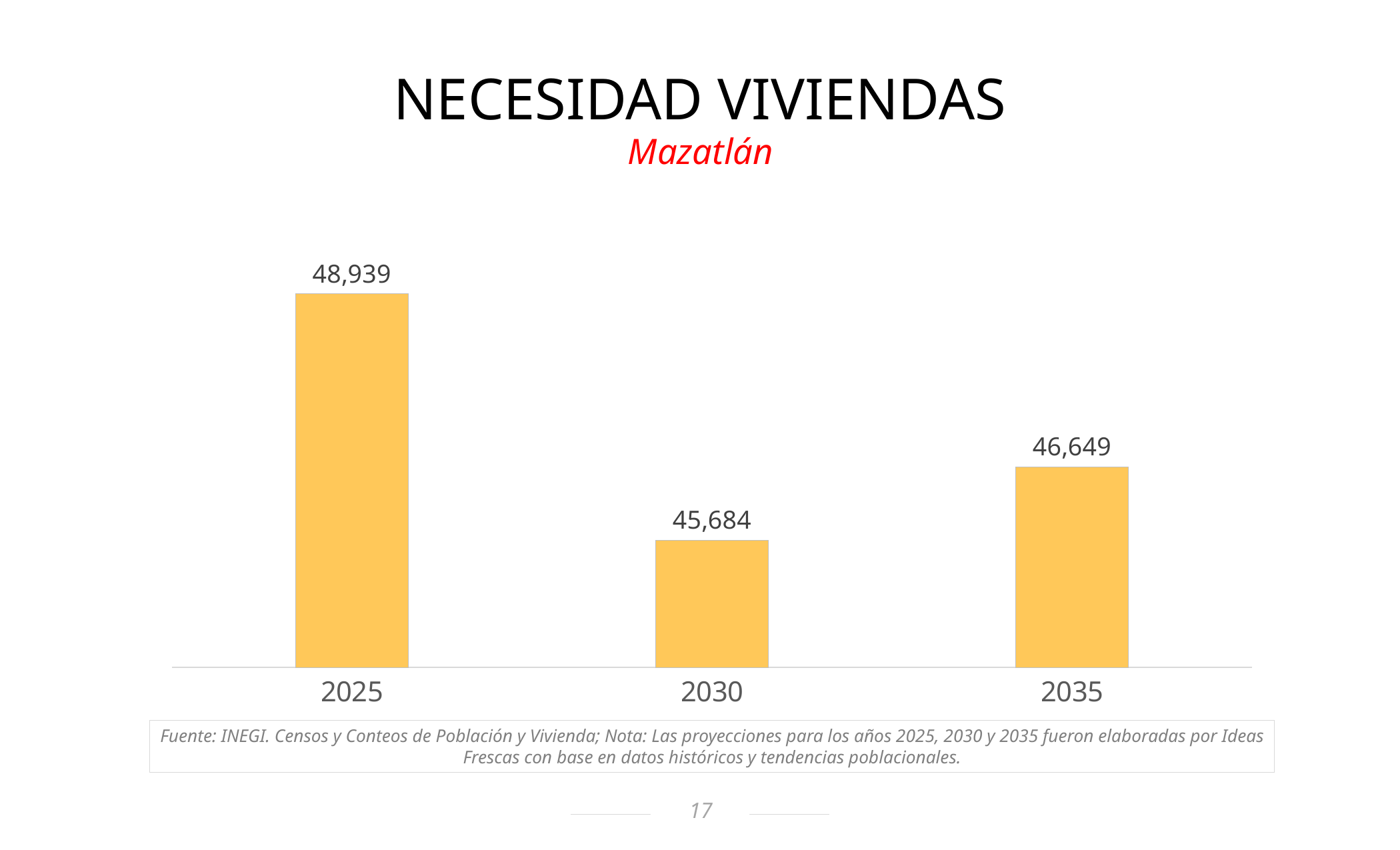
What kind of chart is shown on the slide? Bar chart Which year has the highest value? 2025 What is the title of the chart? NECESIDAD VIVIENDAS Mazatlán What is the value for 2030? 45,684 What is the value for 2035? 46,649 What is the value for 2025? 48,939 How many years are shown on the chart? 3 Which is larger, the value for 2025 or the value for 2035? 2025 Does the value rise or fall from 2025 to 2030? Fall Which year has the lowest value? 2030 What is the difference between the values for 2035 and 2030? 965 What is the difference between the values for 2025 and 2030? 3,255